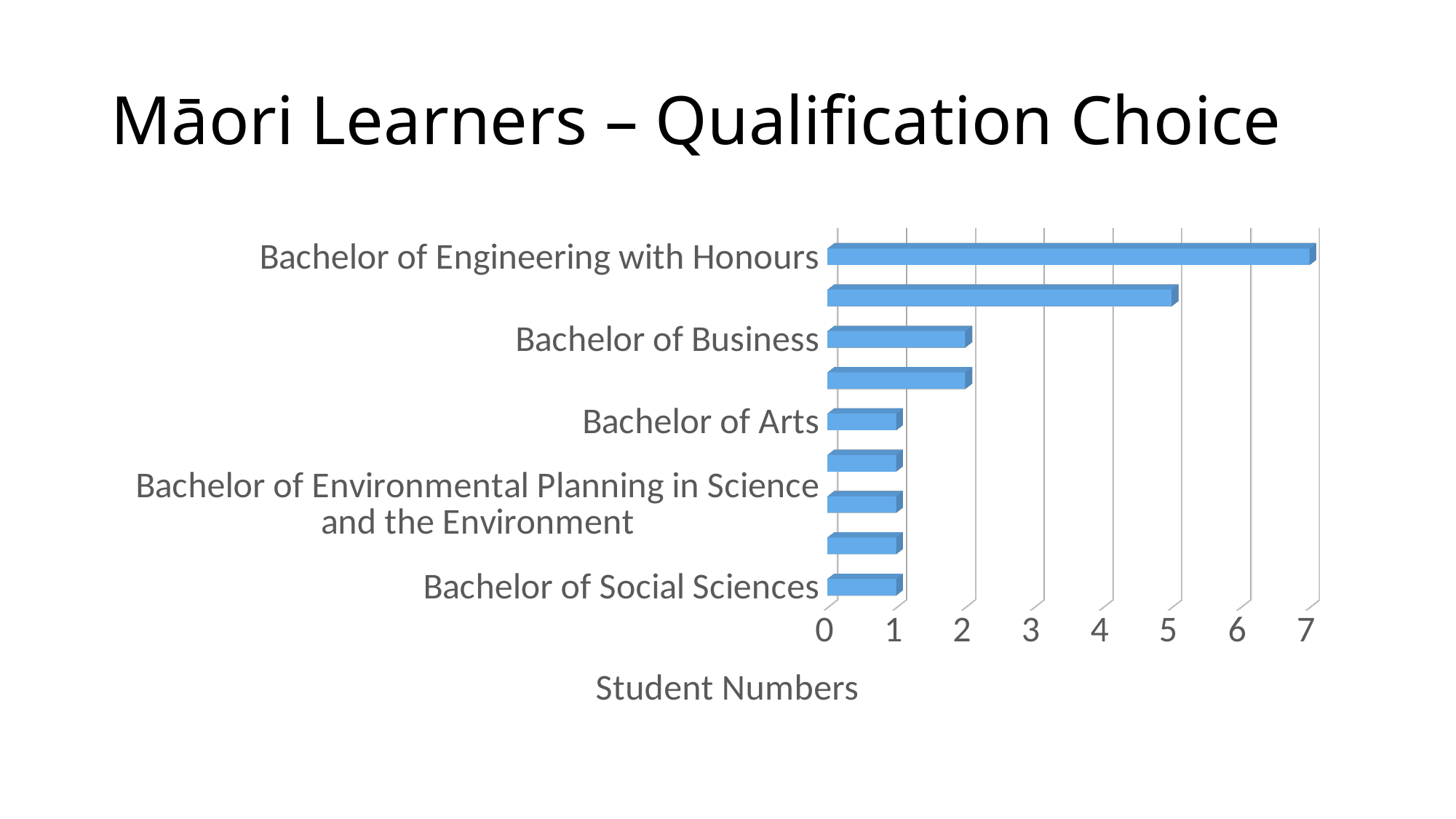
What is the value for Bachelor of Engineering with Honours? 7 What is the value for Bachelor of Social Sciences? 1 Is the value for Bachelor of Engineering with Honours greater or less than 5? greater How many bars are plotted in the chart? 9 What is the value for Bachelor of Environmental Planning in Science and the Environment? 1 Which labelled qualification has the highest student number? Bachelor of Engineering with Honours What is the title of the x axis? Student Numbers What is the value for Bachelor of Business? 2 Which is larger, the value for Bachelor of Business or the value for Bachelor of Arts? Bachelor of Business What is the value for Bachelor of Arts? 1 What kind of chart is shown on the slide? bar chart What is the difference between the values for Bachelor of Engineering with Honours and Bachelor of Business? 5